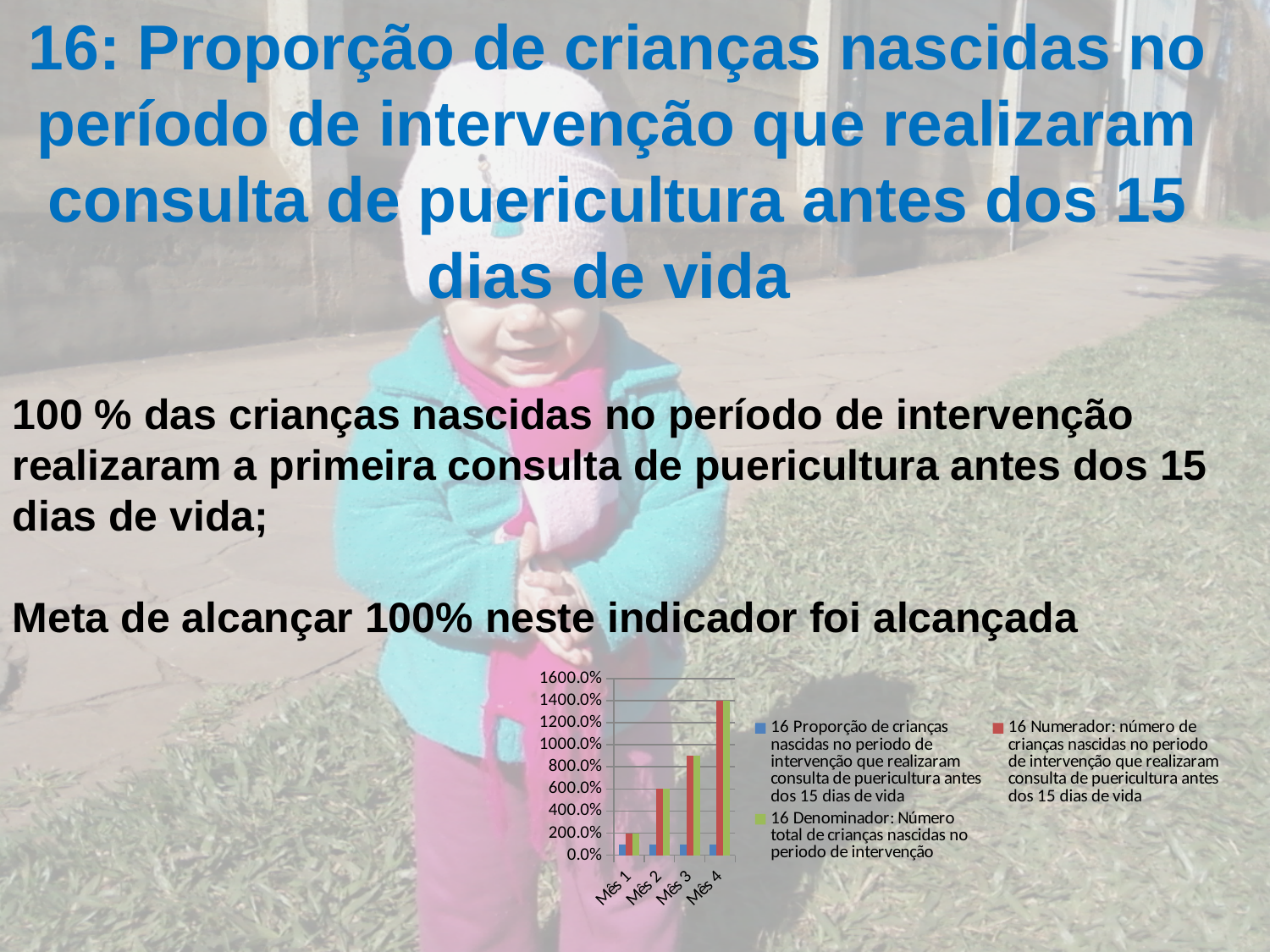
Is the value for '16 Numerador' in Mês 4 greater or less than 1200.0%? greater Which month has the lowest value for the series '16 Denominador'? Mês 1 Is the value for '16 Denominador' in Mês 2 greater or less than 800.0%? less What colour represents the series '16 Denominador' in the chart? green Do the values for the series '16 Numerador' rise or fall from Mês 1 to Mês 4? rise Which month has the highest value for the series '16 Numerador'? Mês 4 How many categories (months) are shown on the x axis of the chart? 4 How many series does the chart legend list? 3 Is the value for '16 Numerador' in Mês 1 greater or less than 400.0%? less What kind of chart is shown on the slide? bar chart What is the highest value shown on the chart's y axis? 1600.0% Which is larger for the series '16 Denominador': the value in Mês 2 or the value in Mês 4? Mês 4